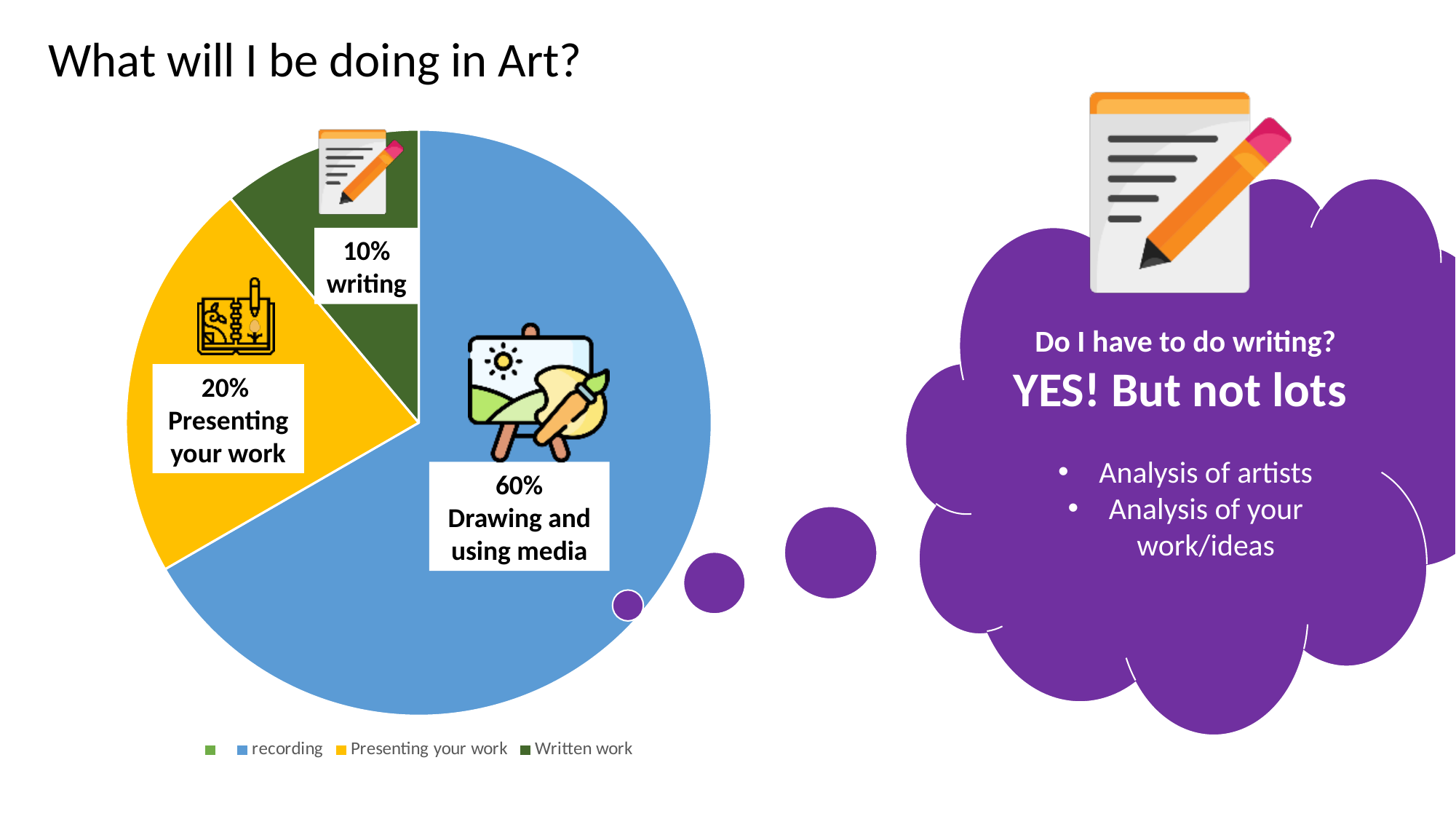
What is the difference in percentage points between the 'Drawing and using media' slice and the 'Presenting your work' slice? 40 Which slice of the pie chart is the largest? Drawing and using media Which legend entry corresponds to the dark green slice? Written work What percentage is labelled on the 'Presenting your work' slice? 20% Which is larger, the 'Presenting your work' slice or the 'writing' slice? Presenting your work How many labelled slices does the pie chart have? 3 What percentage is labelled on the 'Drawing and using media' slice? 60% What percentage is labelled on the 'writing' slice? 10% What is the difference in percentage points between the 'Presenting your work' slice and the 'writing' slice? 10 What kind of chart is shown on the slide? pie chart Which slice of the pie chart is the smallest? writing What colour is the 'Presenting your work' slice? yellow